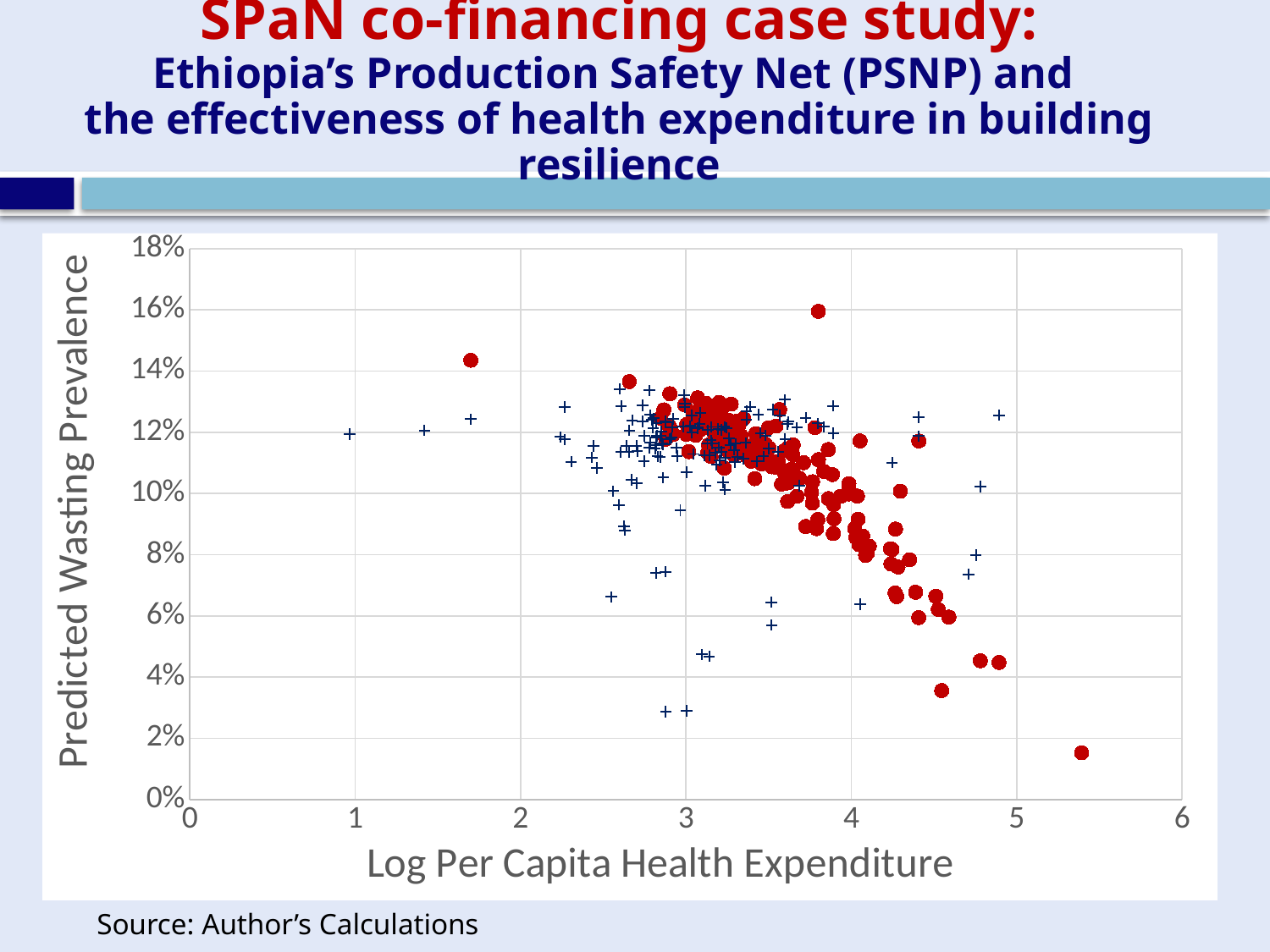
Is the Predicted Wasting Prevalence of the rightmost red point (near x = 5.4) greater or less than 2%? less What kind of chart is shown on the slide? scatter chart Is the Predicted Wasting Prevalence of the leftmost blue cross (near x = 1) greater or less than 10%? greater What is the title of the x axis of the chart? Log Per Capita Health Expenditure Is the Predicted Wasting Prevalence of the highest red point (near x = 3.8) greater or less than 14%? greater As Log Per Capita Health Expenditure increases beyond 3, do the red points generally rise or fall in Predicted Wasting Prevalence? fall What is the maximum value shown on the y axis? 18% What is the title of the y axis of the chart? Predicted Wasting Prevalence Which has the higher Predicted Wasting Prevalence: the red point near x = 1.7 or the red point near x = 5.4? the red point near x = 1.7